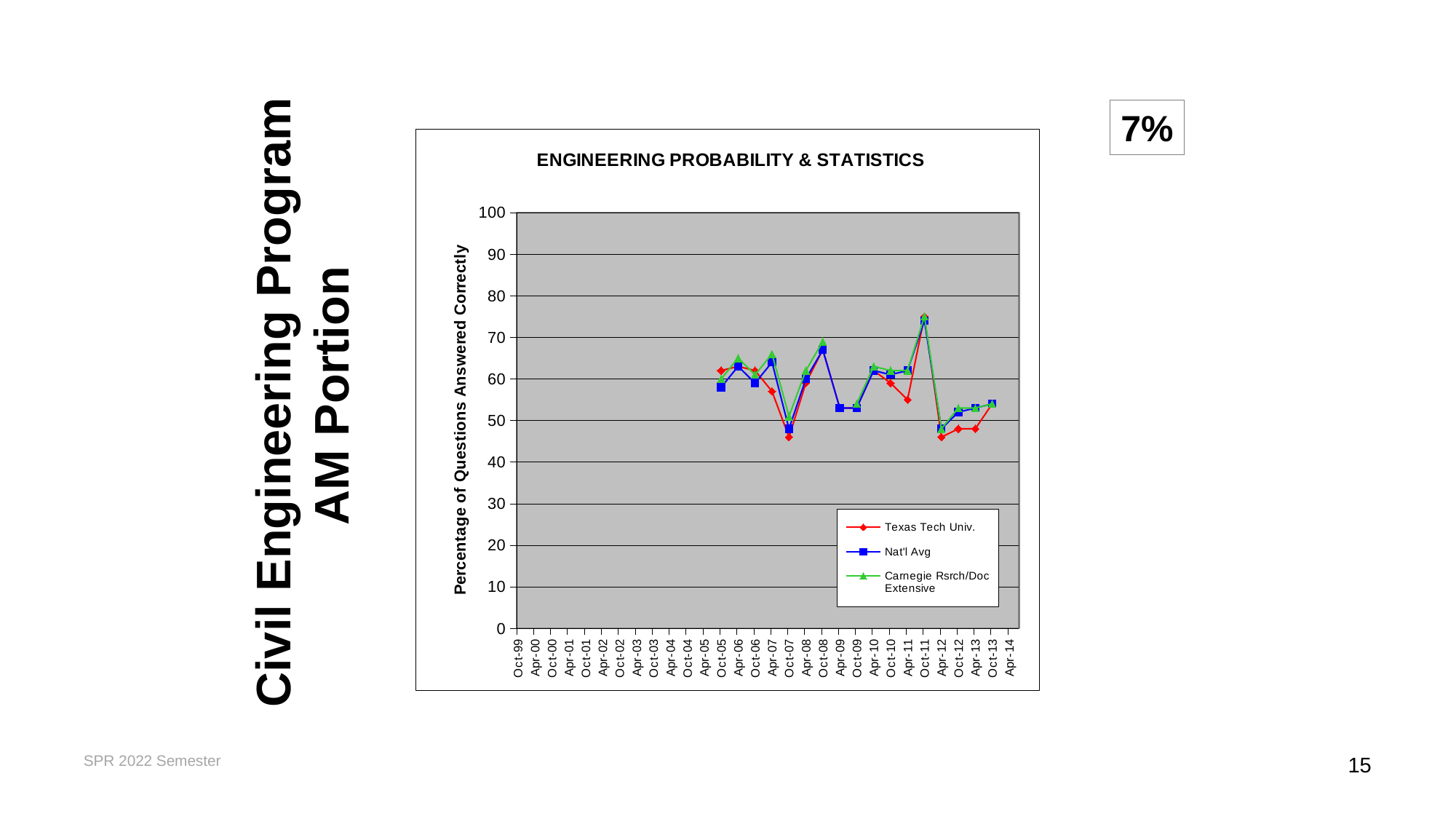
Is the value for Texas Tech Univ. at Oct-07 greater or less than 50? less Is the value for Nat'l Avg at Oct-08 greater or less than 60? greater How many series does the legend list? 3 What kind of chart is shown on the slide? line chart At Apr-11, which is larger: Texas Tech Univ. or Nat'l Avg? Nat'l Avg Does the Texas Tech Univ. series rise or fall from Apr-12 to Oct-13? rise What is the label on the vertical axis? Percentage of Questions Answered Correctly At which date does the Texas Tech Univ. series reach its highest value? Oct-11 Does the Texas Tech Univ. series rise or fall from Oct-11 to Apr-12? fall What is the title of the chart? ENGINEERING PROBABILITY & STATISTICS Is the value for Texas Tech Univ. at Oct-11 greater or less than 70? greater